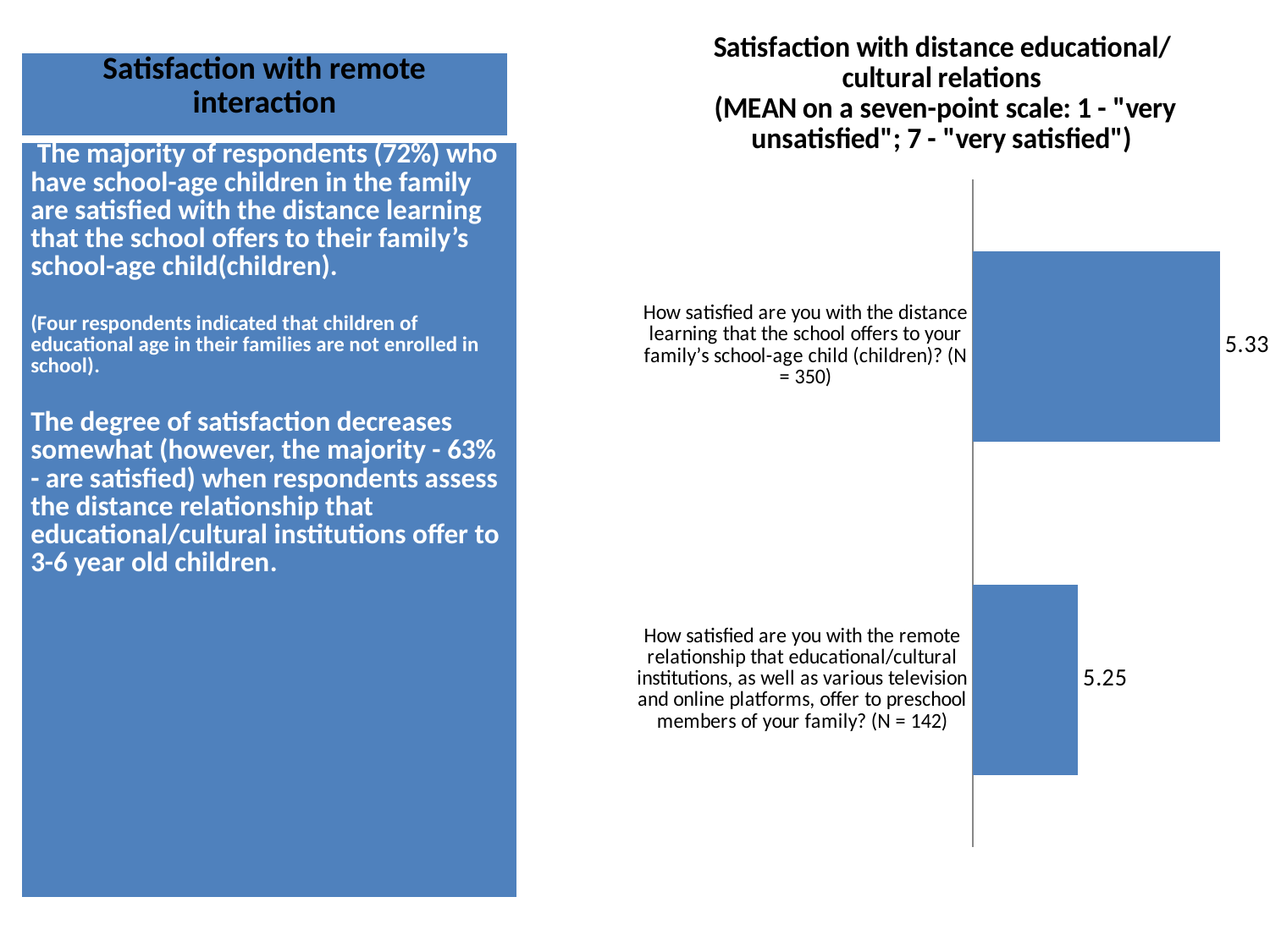
Is the mean satisfaction with school distance learning (N = 350) larger or smaller than the mean satisfaction with remote relationships for preschool children (N = 142)? larger Which item has the higher mean satisfaction score? How satisfied are you with the distance learning that the school offers to your family's school-age child (children)? (N = 350) What is the mean satisfaction value for the distance learning that the school offers to school-age children (N = 350)? 5.33 What is the difference between the mean satisfaction with school distance learning (5.33) and the mean satisfaction with remote relationships offered to preschool children (5.25)? 0.08 Which item has the lower mean satisfaction score? How satisfied are you with the remote relationship that educational/cultural institutions, as well as various television and online platforms, offer to preschool members of your family? (N = 142) What type of chart is shown on the slide? bar chart What is the mean satisfaction value for the remote relationship that educational/cultural institutions offer to preschool members of the family (N = 142)? 5.25 How many categories (questions) are plotted in the chart? 2 What is the sample size (N) for the question about distance learning offered by the school? 350 What is the title of the chart? Satisfaction with distance educational/ cultural relations (MEAN on a seven-point scale: 1 - "very unsatisfied"; 7 - "very satisfied")